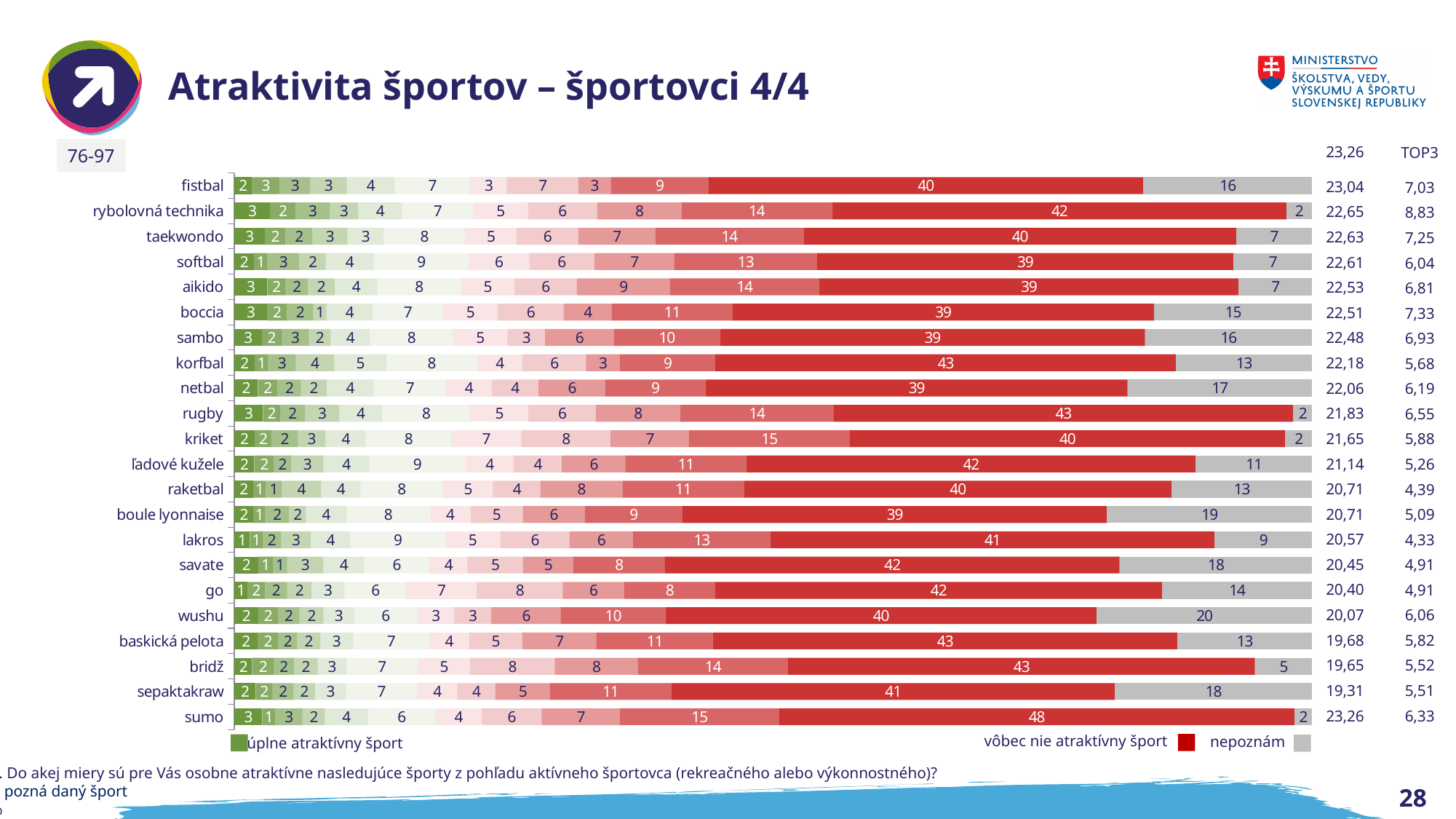
Which sport has the highest 'nepoznám' value? wushu What is the 'vôbec nie atraktívny šport' value for sumo? 48 What is the total of all segments in the fistbal bar? 100 What is the 'nepoznám' value for fistbal? 16 How many sports are listed on the chart? 22 Which sport has the highest 'vôbec nie atraktívny šport' value? sumo What is the 'vôbec nie atraktívny šport' value for korfbal? 43 What kind of chart is shown on the slide? stacked bar chart What is the difference between the 'nepoznám' values for netbal and fistbal? 1 What is the title of the chart? Atraktivita športov – športovci 4/4 Which has the larger 'vôbec nie atraktívny šport' value, rugby or fistbal? rugby What is the 'nepoznám' value for boule lyonnaise? 19